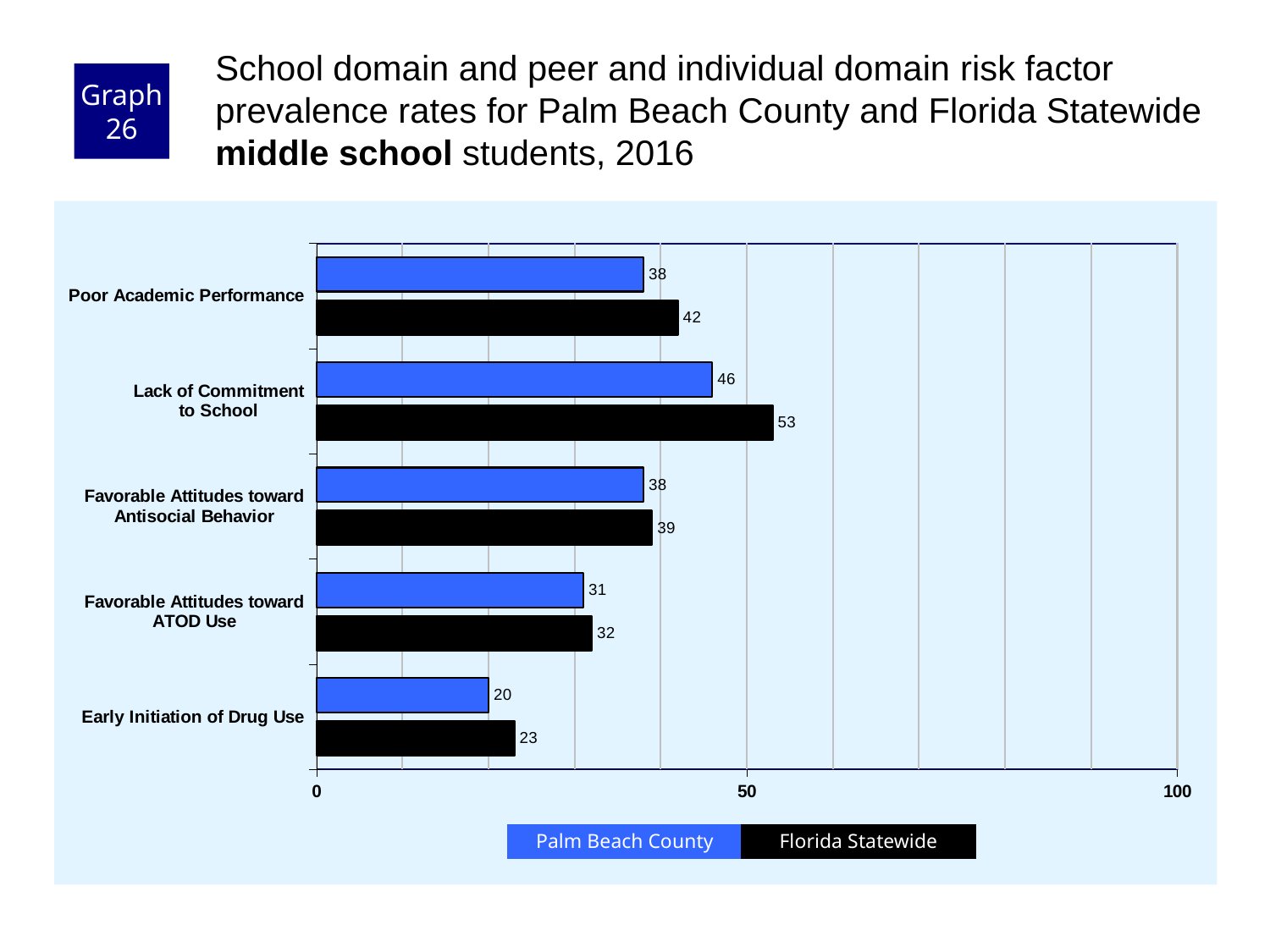
Is the Florida Statewide value for Lack of Commitment to School greater or less than 50? greater What is the Florida Statewide value for Poor Academic Performance? 42 How many risk factor categories are shown on the chart? 5 What is the Palm Beach County value for Lack of Commitment to School? 46 Which risk factor has the highest Florida Statewide value? Lack of Commitment to School How many series does the legend list? 2 Which colour represents Florida Statewide in the chart? Black What is the Florida Statewide value for Early Initiation of Drug Use? 23 What is the difference between the Florida Statewide and Palm Beach County values for Lack of Commitment to School? 7 For Poor Academic Performance, which is larger: the Palm Beach County value or the Florida Statewide value? Florida Statewide Which risk factor has the lowest Palm Beach County value? Early Initiation of Drug Use What kind of chart is shown on the slide? Bar chart